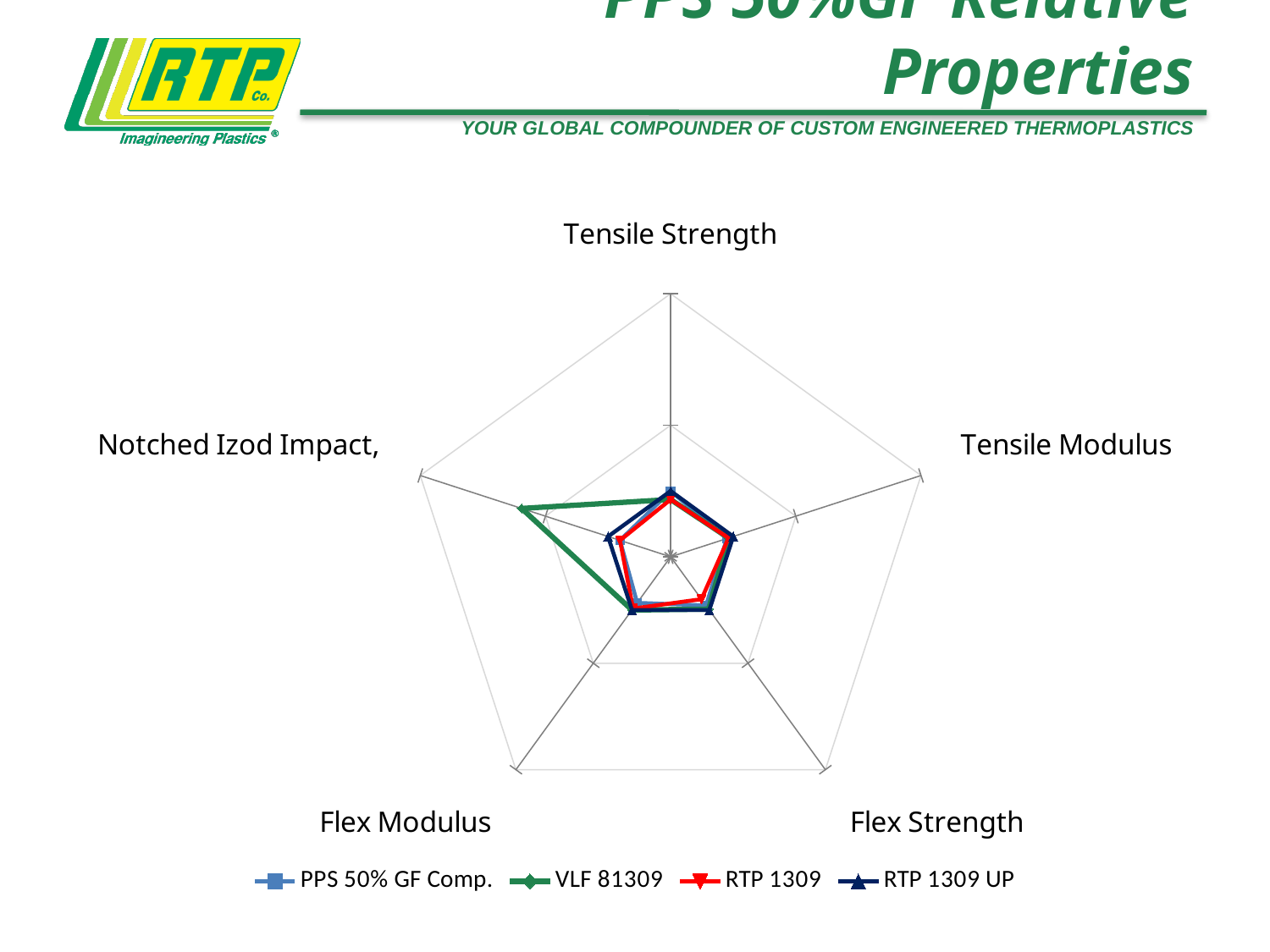
Which series has the highest value on the Notched Izod Impact axis? VLF 81309 On the Notched Izod Impact axis, which is larger: VLF 81309 or RTP 1309? VLF 81309 How many property axes does the radar chart have? 5 How many series does the legend list? 4 What kind of chart is shown on the slide? Radar chart On the Tensile Modulus axis, which is larger: RTP 1309 UP or RTP 1309? RTP 1309 UP Which series is drawn in green on the chart? VLF 81309 Which series is drawn in red on the chart? RTP 1309 Which property axis is at the top of the radar chart? Tensile Strength